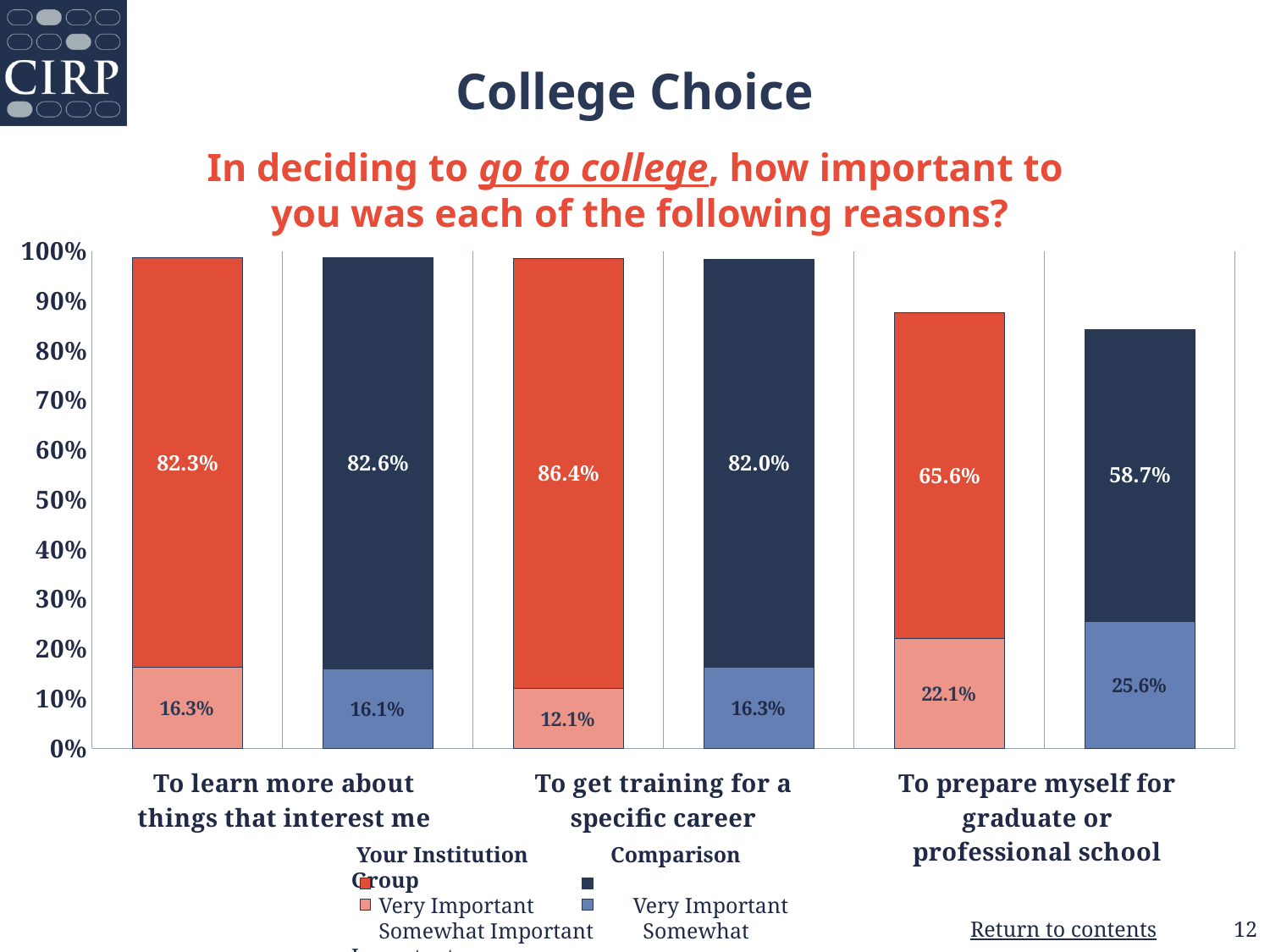
How many reasons (categories) are shown on the x axis of the chart? 3 What percentage of Your Institution respondents rated 'To get training for a specific career' as Very Important? 86.4% Which reason has the highest Very Important percentage for Your Institution? To get training for a specific career What type of chart is shown on the slide? Stacked bar chart How many entries does the chart legend list? 4 What percentage of Your Institution respondents rated 'To learn more about things that interest me' as Somewhat Important? 16.3% What is the difference between the Your Institution and Comparison Group Very Important percentages for 'To get training for a specific career'? 4.4 percentage points What percentage of the Comparison Group rated 'To prepare myself for graduate or professional school' as Somewhat Important? 25.6% What percentage of the Comparison Group rated 'To prepare myself for graduate or professional school' as Very Important? 58.7% What is the combined Very Important and Somewhat Important percentage for Your Institution on 'To prepare myself for graduate or professional school'? 87.7% Which reason has the lowest Very Important percentage for Your Institution? To prepare myself for graduate or professional school For 'To prepare myself for graduate or professional school', which group has the larger Very Important percentage, Your Institution or the Comparison Group? Your Institution